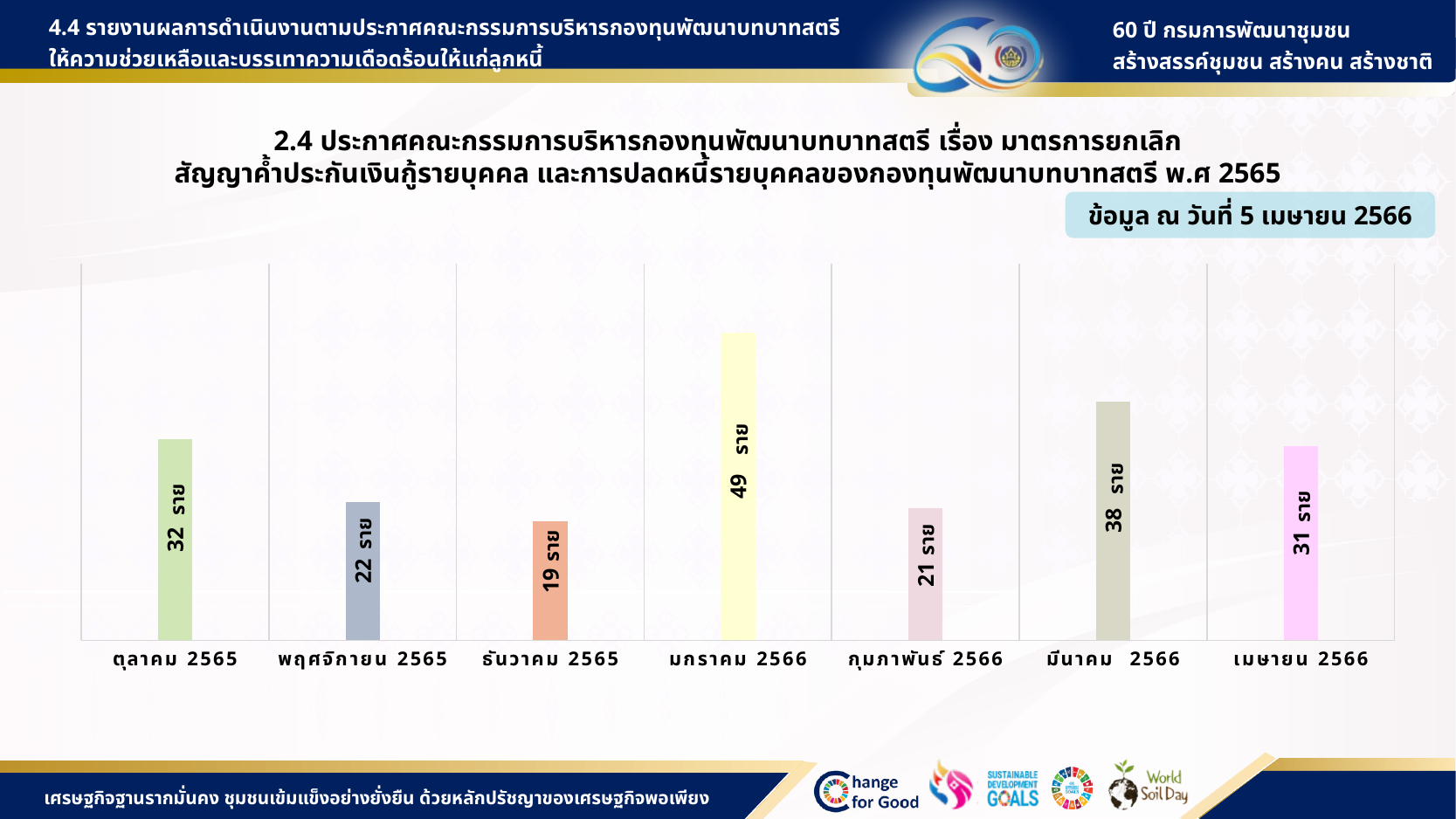
Which is larger, the value for ตุลาคม 2565 or the value for มีนาคม 2566? มีนาคม 2566 What is the value shown for มกราคม 2566? 49 ราย Which month has the highest value? มกราคม 2566 What kind of chart is shown on the slide? Bar chart Which is larger, the value for กุมภาพันธ์ 2566 or the value for เมษายน 2566? เมษายน 2566 What is the value shown for ธันวาคม 2565? 19 ราย Which month has the lowest value? ธันวาคม 2565 What is the value shown for เมษายน 2566? 31 ราย What is the difference between the values for มกราคม 2566 and มีนาคม 2566? 11 ราย What date is the data on the slide stated to be as of? 5 เมษายน 2566 How many months are shown on the chart? 7 What is the difference between the values for ตุลาคม 2565 and พฤศจิกายน 2565? 10 ราย